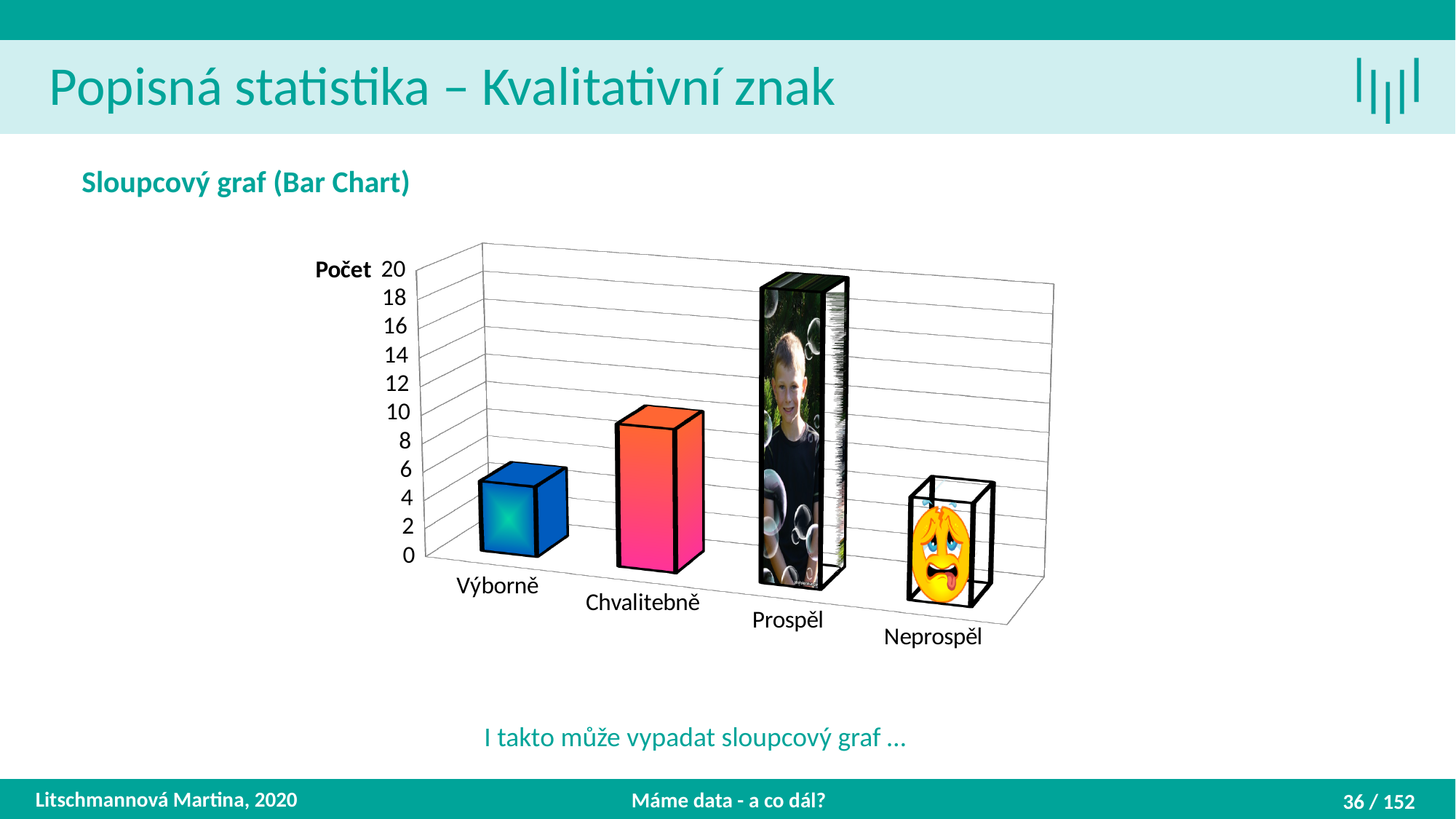
Is the value for Prospěl greater or less than 14? greater Which is larger, the value for Prospěl or the value for Neprospěl? Prospěl Is the value for Neprospěl greater or less than 10? less What is the highest tick value shown on the vertical axis? 20 Which is larger, the value for Chvalitebně or the value for Výborně? Chvalitebně What kind of chart is shown on the slide? bar chart How many categories are shown on the x axis of the chart? 4 Which category has the highest bar in the chart? Prospěl Is the value for Chvalitebně greater or less than 14? less What is the label of the vertical axis of the chart? Počet